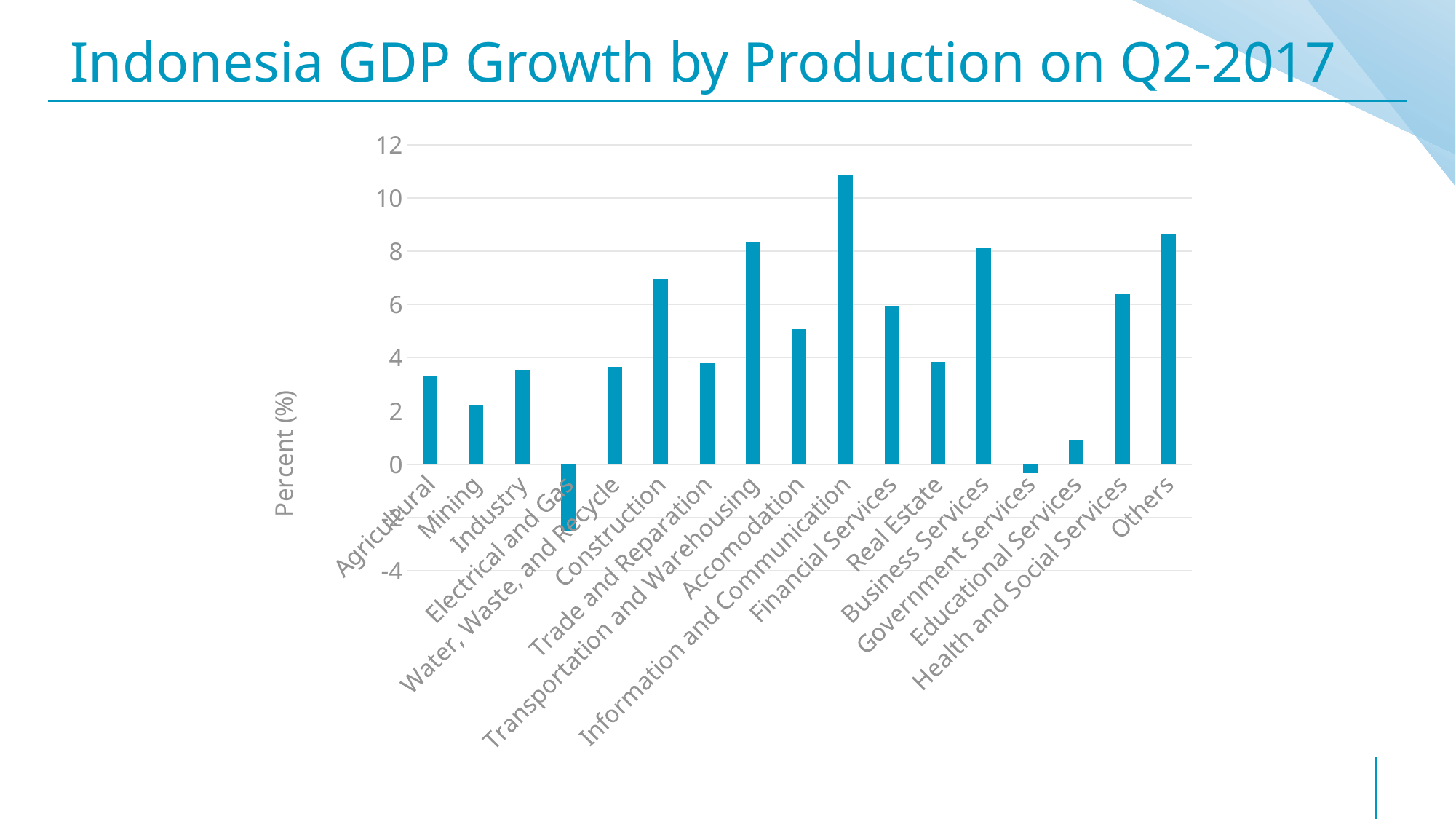
Which category has the lowest GDP growth? Electrical and Gas Which category has the highest GDP growth? Information and Communication Is the value for Mining greater or less than 4? less What kind of chart is shown on the slide? bar chart Is the value for Electrical and Gas greater or less than 0? less What is the label on the vertical axis? Percent (%) Which is larger, the value for Educational Services or the value for Health and Social Services? Health and Social Services Which is larger, the value for Transportation and Warehousing or the value for Accomodation? Transportation and Warehousing How many categories are plotted on the x axis? 17 What is the title of the chart? Indonesia GDP Growth by Production on Q2-2017 Is the value for Construction greater or less than 6? greater